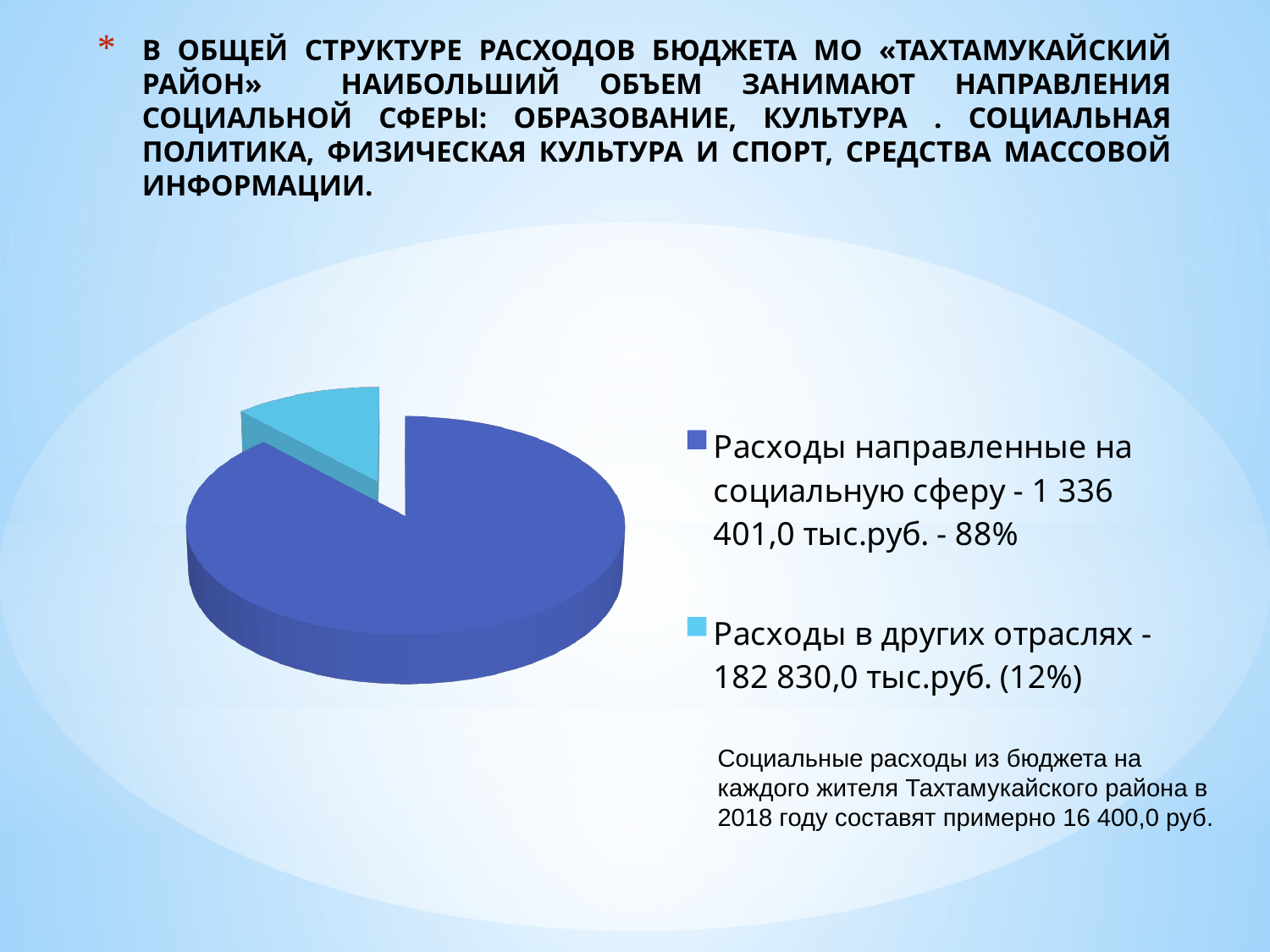
Which is larger: «Расходы направленные на социальную сферу» or «Расходы в других отраслях»? Расходы направленные на социальную сферу By how many percentage points does the share of «Расходы направленные на социальную сферу» exceed the share of «Расходы в других отраслях»? 76% What share of the pie is taken by «Расходы направленные на социальную сферу»? 88% What share of the pie is taken by «Расходы в других отраслях»? 12% What colour is the slice for «Расходы в других отраслях»? light blue What kind of chart is shown on the slide? pie chart What is the amount shown for «Расходы в других отраслях»? 182 830,0 тыс.руб. How many slices does the pie chart have? 2 How many entries does the legend of the pie chart list? 2 Which category has the smallest slice of the pie? Расходы в других отраслях Which category has the largest slice of the pie? Расходы направленные на социальную сферу What is the amount shown for «Расходы направленные на социальную сферу»? 1 336 401,0 тыс.руб.